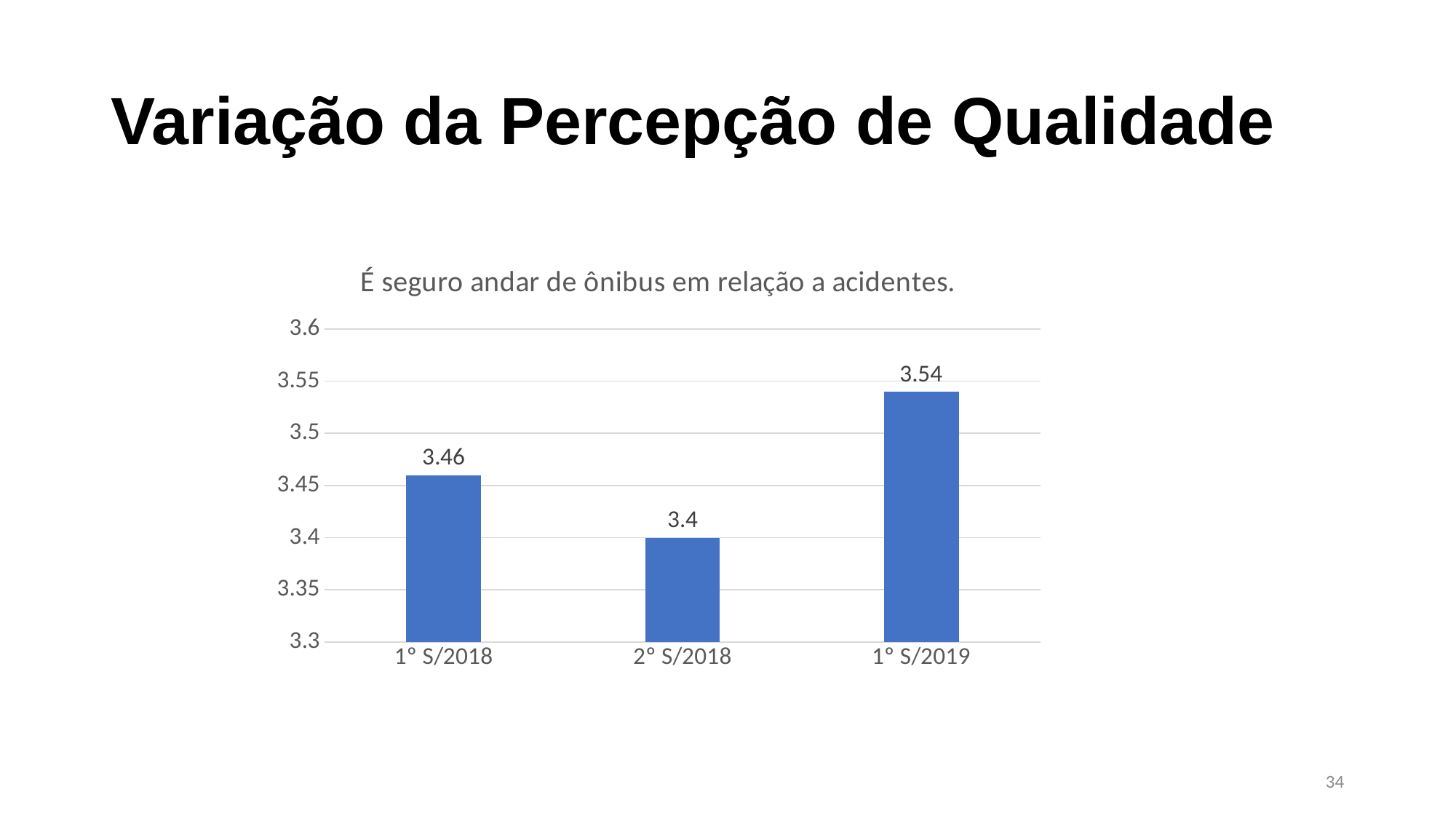
What is the value for 1° S/2018? 3.46 How many categories are shown on the x axis? 3 What kind of chart is shown on the slide? bar chart What is the difference between the values for 1° S/2019 and 2° S/2018? 0.14 What is the value for 2° S/2018? 3.4 Which is larger, the value for 1° S/2018 or the value for 1° S/2019? 1° S/2019 What is the title of the chart? É seguro andar de ônibus em relação a acidentes. Is the value for 1° S/2019 greater or less than 3.5? greater What is the difference between the values for 1° S/2018 and 2° S/2018? 0.06 What is the value for 1° S/2019? 3.54 Which category has the highest value? 1° S/2019 Which category has the lowest value? 2° S/2018